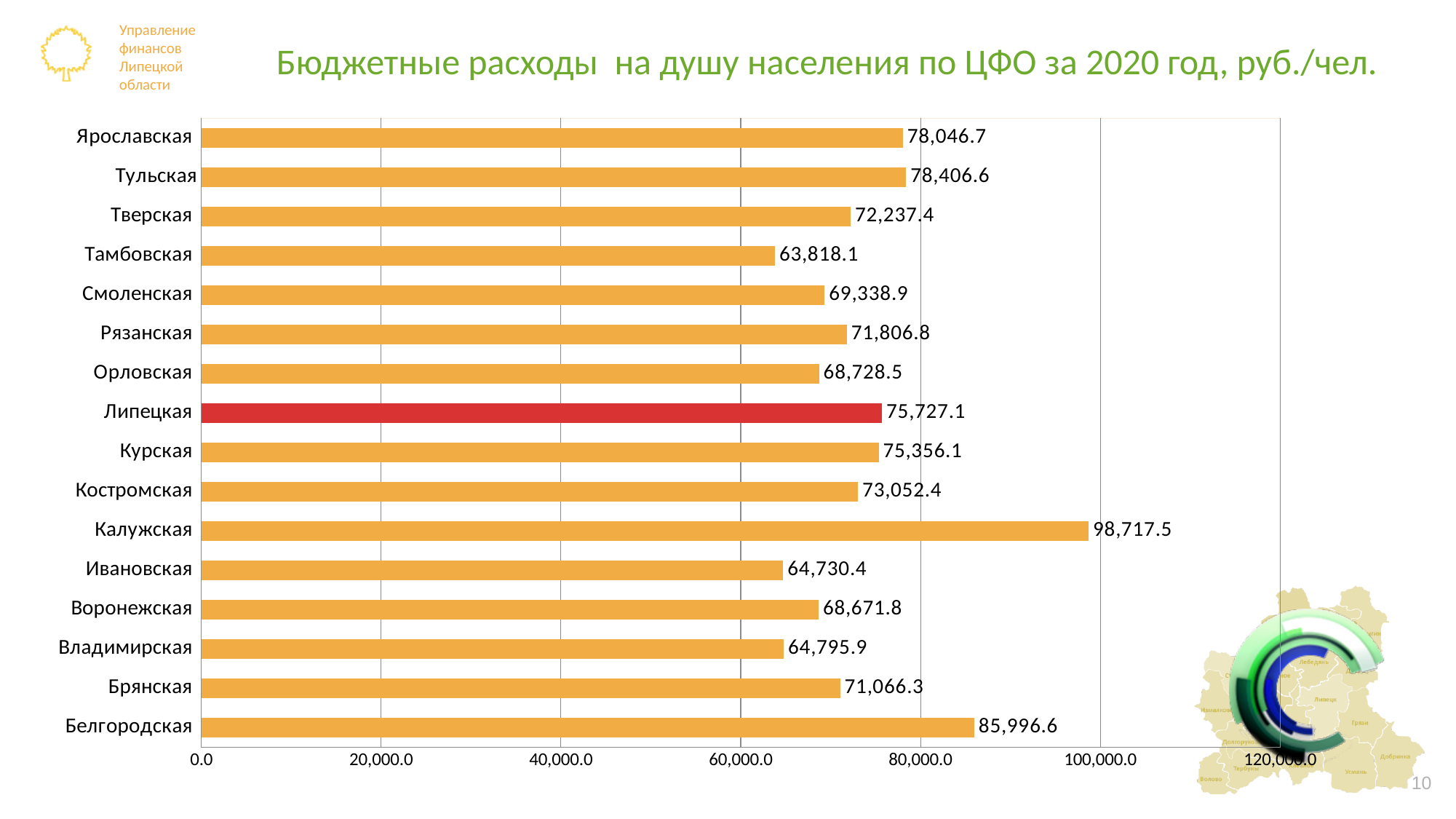
Which region has the lowest value? Тамбовская What is the value for Липецкая? 75,727.1 Which is larger, the value for Тульская or the value for Ярославская? Тульская What is the value for Белгородская? 85,996.6 Which region's bar is coloured red instead of orange? Липецкая What is the difference between the values for Липецкая and Курская? 371.0 How many regions are shown in the chart? 16 Which region has the highest value? Калужская What is the value for Калужская? 98,717.5 What kind of chart is shown on the slide? bar chart Is the value for Белгородская greater or less than 80,000.0? greater What is the difference between the values for Калужская and Белгородская? 12,720.9